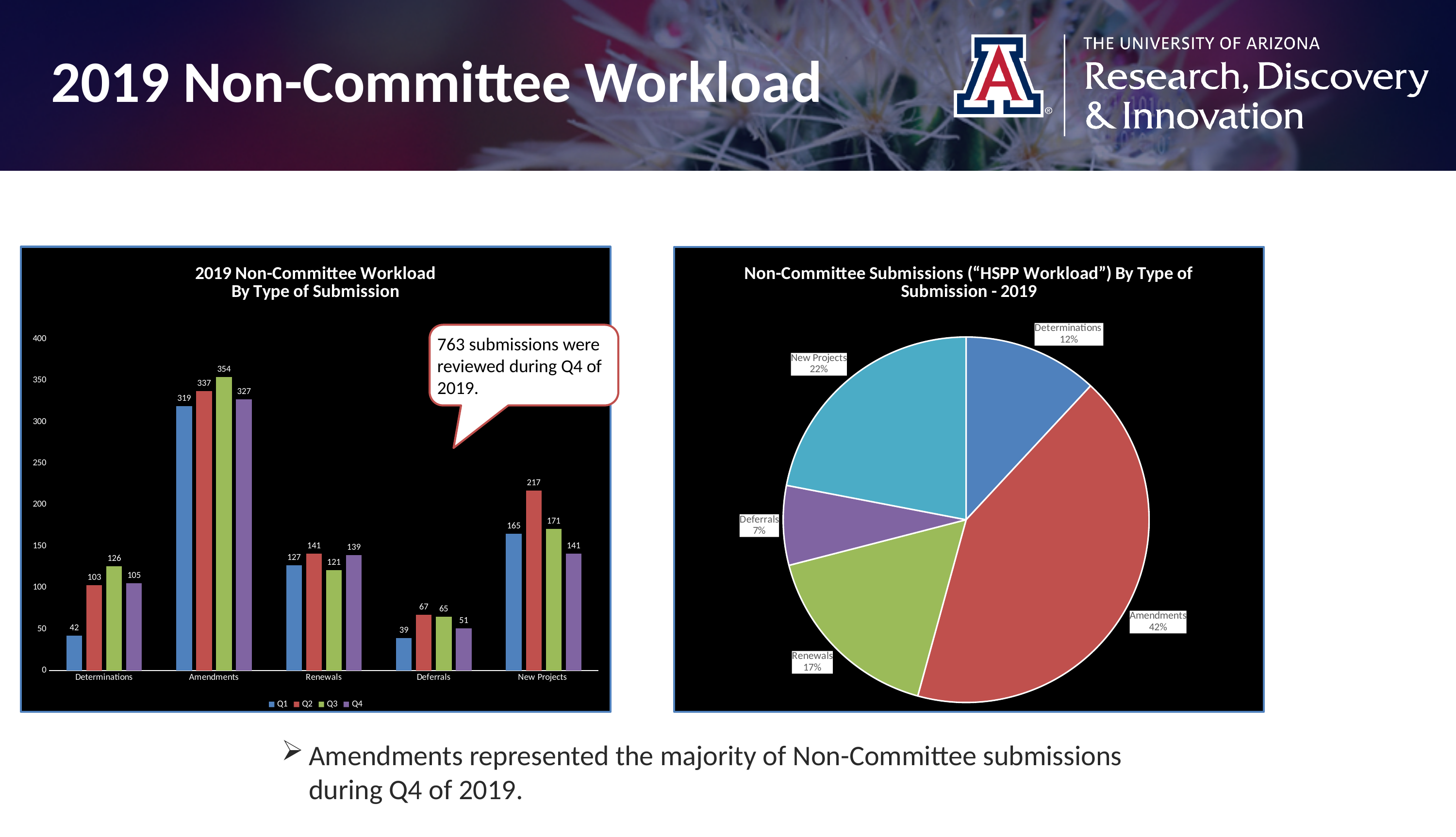
In the bar chart '2019 Non-Committee Workload By Type of Submission', what is the difference between the Q2 and Q1 values for Determinations? 61 In the bar chart '2019 Non-Committee Workload By Type of Submission', which submission type has the highest Q4 value? Amendments In the bar chart '2019 Non-Committee Workload By Type of Submission', which submission type has the lowest Q1 value? Deferrals In the bar chart '2019 Non-Committee Workload By Type of Submission', which is larger for Renewals: the Q2 value or the Q4 value? Q2 In the pie chart on the right, which submission type has the smallest slice? Deferrals In the bar chart '2019 Non-Committee Workload By Type of Submission', what is the Q1 value for Determinations? 42 What kind of chart is the chart on the right, 'Non-Committee Submissions ("HSPP Workload") By Type of Submission - 2019'? pie chart In the pie chart on the right, what share of submissions is Amendments? 42% In the bar chart '2019 Non-Committee Workload By Type of Submission', what is the Q3 value for Amendments? 354 In the bar chart '2019 Non-Committee Workload By Type of Submission', what is the Q2 value for New Projects? 217 How many series does the legend of the bar chart '2019 Non-Committee Workload By Type of Submission' list? 4 How many submission types are shown on the x axis of the bar chart '2019 Non-Committee Workload By Type of Submission'? 5